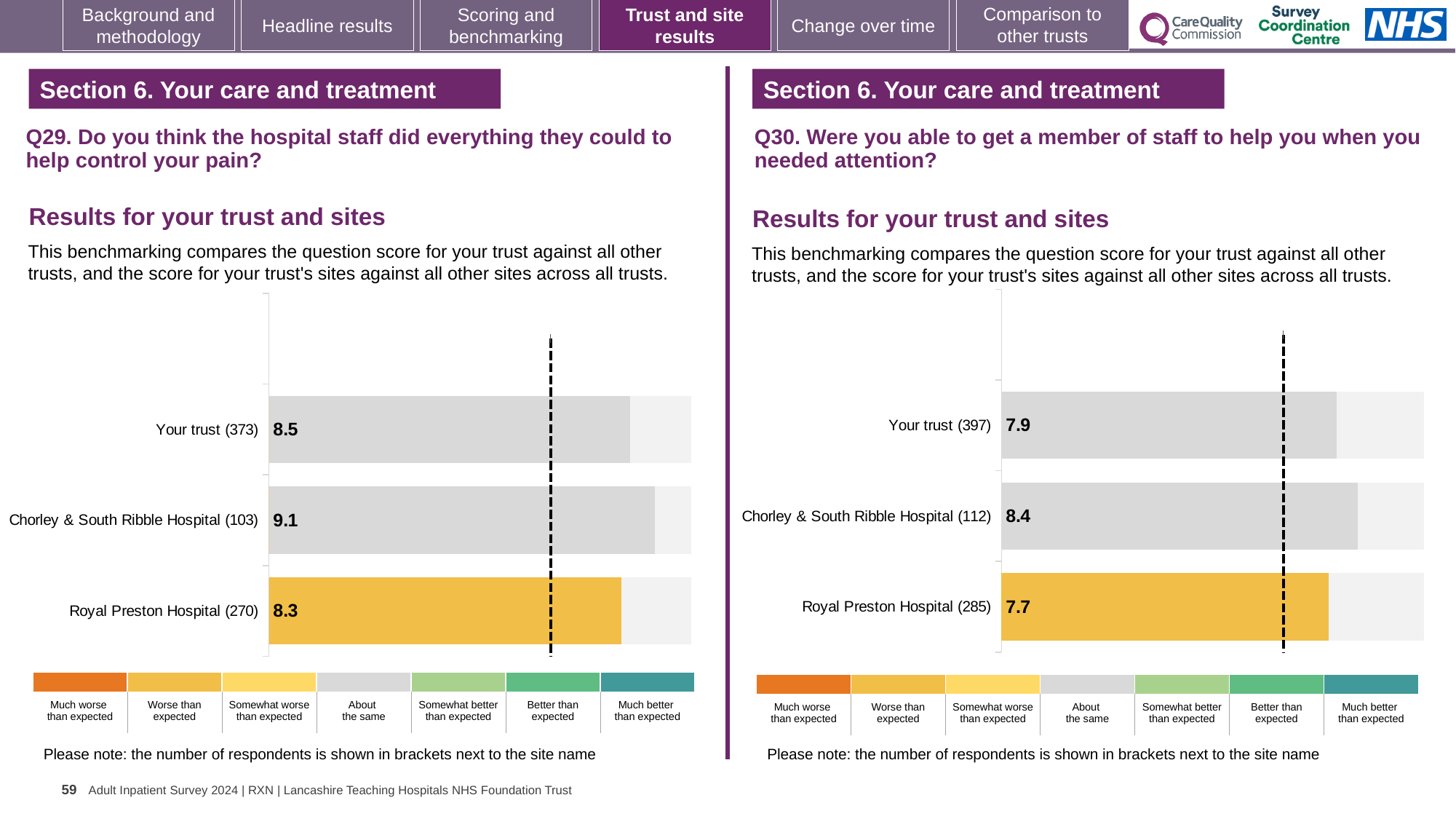
On the Q29 chart (left), what is the score for Royal Preston Hospital? 8.3 On the Q29 chart (left), what is the score for Your trust? 8.5 On the Q29 chart (left), which site or trust has the lowest score? Royal Preston Hospital How many bars are plotted on the Q29 chart (left)? 3 On the Q30 chart (right), what is the difference between the scores for Chorley & South Ribble Hospital and Your trust? 0.5 On the Q30 chart (right), which has the larger score: Your trust or Royal Preston Hospital? Your trust On the Q29 chart (left), what is the difference between the scores for Chorley & South Ribble Hospital and Royal Preston Hospital? 0.8 On the Q30 chart (right), what is the score for Royal Preston Hospital? 7.7 On the Q30 chart (right), which site or trust has the highest score? Chorley & South Ribble Hospital What kind of chart is used on the Q30 chart (right)? Bar chart On the Q29 chart (left), what is the score for Chorley & South Ribble Hospital? 9.1 On the Q30 chart (right), what is the score for Your trust? 7.9